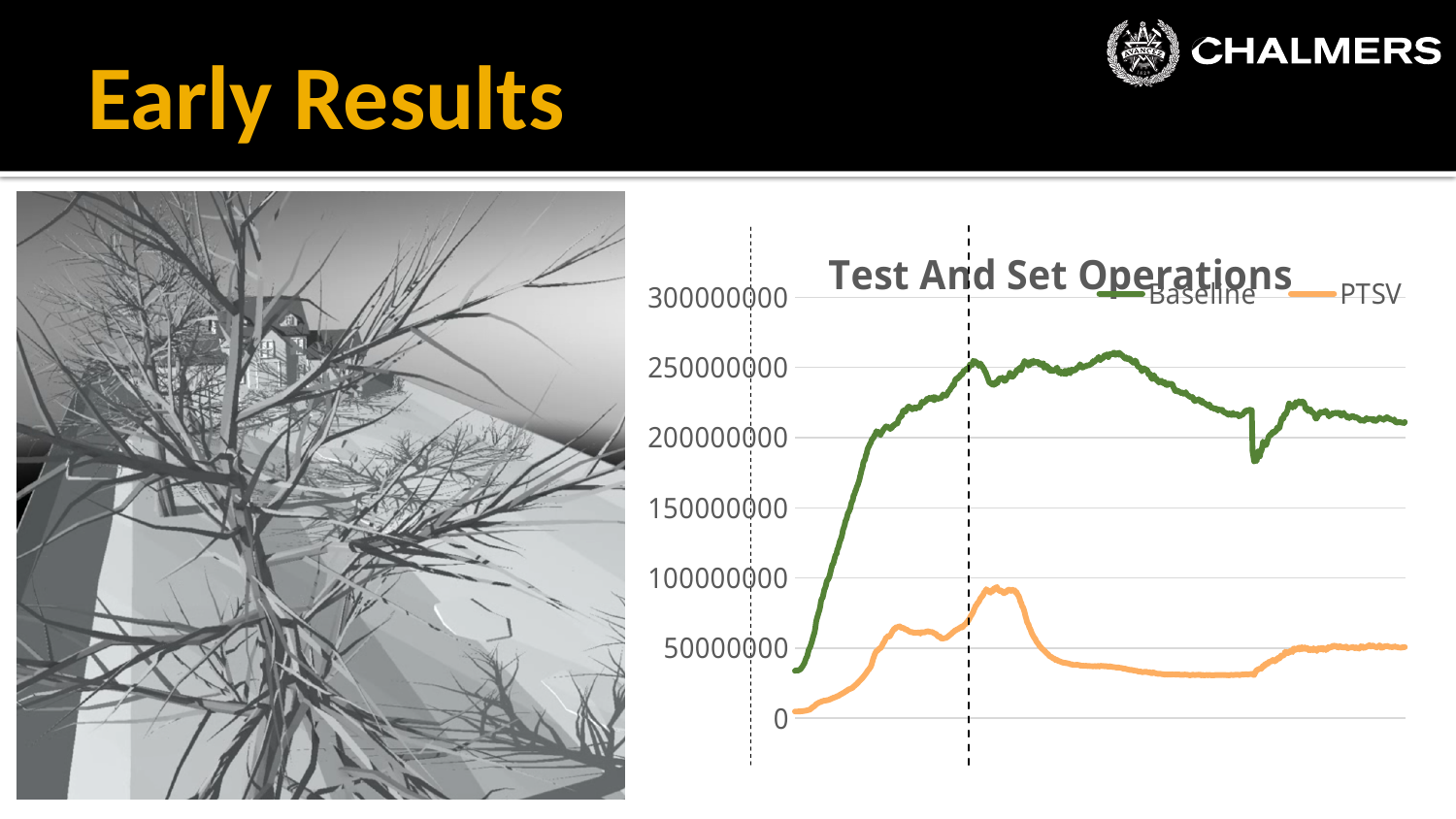
What is the highest value shown on the chart's vertical axis? 300000000 How many series does the chart's legend list? 2 What is the title of the chart? Test And Set Operations Is the highest value reached by the PTSV series greater or less than 150000000? less Does the Baseline series rise or fall at the beginning of the chart? rise Is the lowest value of the PTSV series greater or less than 50000000? less What kind of chart is shown on the slide? line chart Is the value of the Baseline series at the start of the chart greater or less than 100000000? less Which series has higher values throughout the chart, Baseline or PTSV? Baseline What are the names of the two series in the chart's legend? Baseline and PTSV